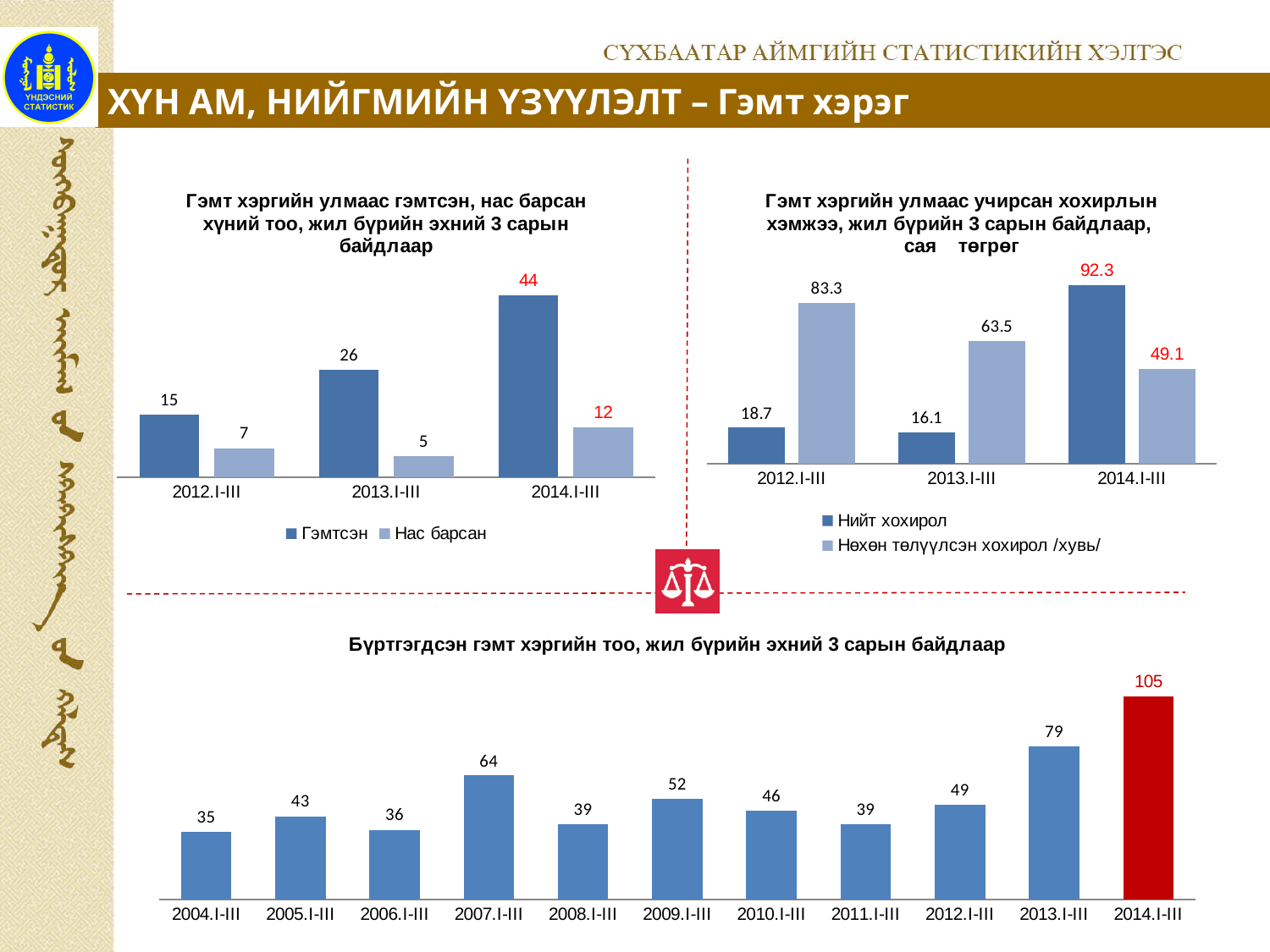
In the bottom chart (Бүртгэгдсэн гэмт хэргийн тоо), how many periods are shown on the x axis? 11 In the top-right chart (Гэмт хэргийн улмаас учирсан хохирлын хэмжээ), what is the Нийт хохирол value for 2014.I-III? 92.3 What type of chart is the bottom chart (Бүртгэгдсэн гэмт хэргийн тоо)? bar chart In the top-left chart (Гэмт хэргийн улмаас гэмтсэн, нас барсан хүний тоо), does the Гэмтсэн series rise or fall from 2012.I-III to 2014.I-III? rise In the bottom chart (Бүртгэгдсэн гэмт хэргийн тоо), which is larger, the value for 2007.I-III or 2009.I-III? 2007.I-III In the top-left chart (Гэмт хэргийн улмаас гэмтсэн, нас барсан хүний тоо), what is the Гэмтсэн value for 2013.I-III? 26 In the top-left chart (Гэмт хэргийн улмаас гэмтсэн, нас барсан хүний тоо), how many series does the legend list? 2 In the bottom chart (Бүртгэгдсэн гэмт хэргийн тоо), what is the difference between the values for 2014.I-III and 2013.I-III? 26 In the bottom chart (Бүртгэгдсэн гэмт хэргийн тоо), which period has the lowest value? 2004.I-III In the bottom chart (Бүртгэгдсэн гэмт хэргийн тоо), what is the value for 2014.I-III? 105 In the top-right chart (Гэмт хэргийн улмаас учирсан хохирлын хэмжээ), which period has the lowest Нийт хохирол value? 2013.I-III In the top-left chart (Гэмт хэргийн улмаас гэмтсэн, нас барсан хүний тоо), what is the Нас барсан value for 2014.I-III? 12